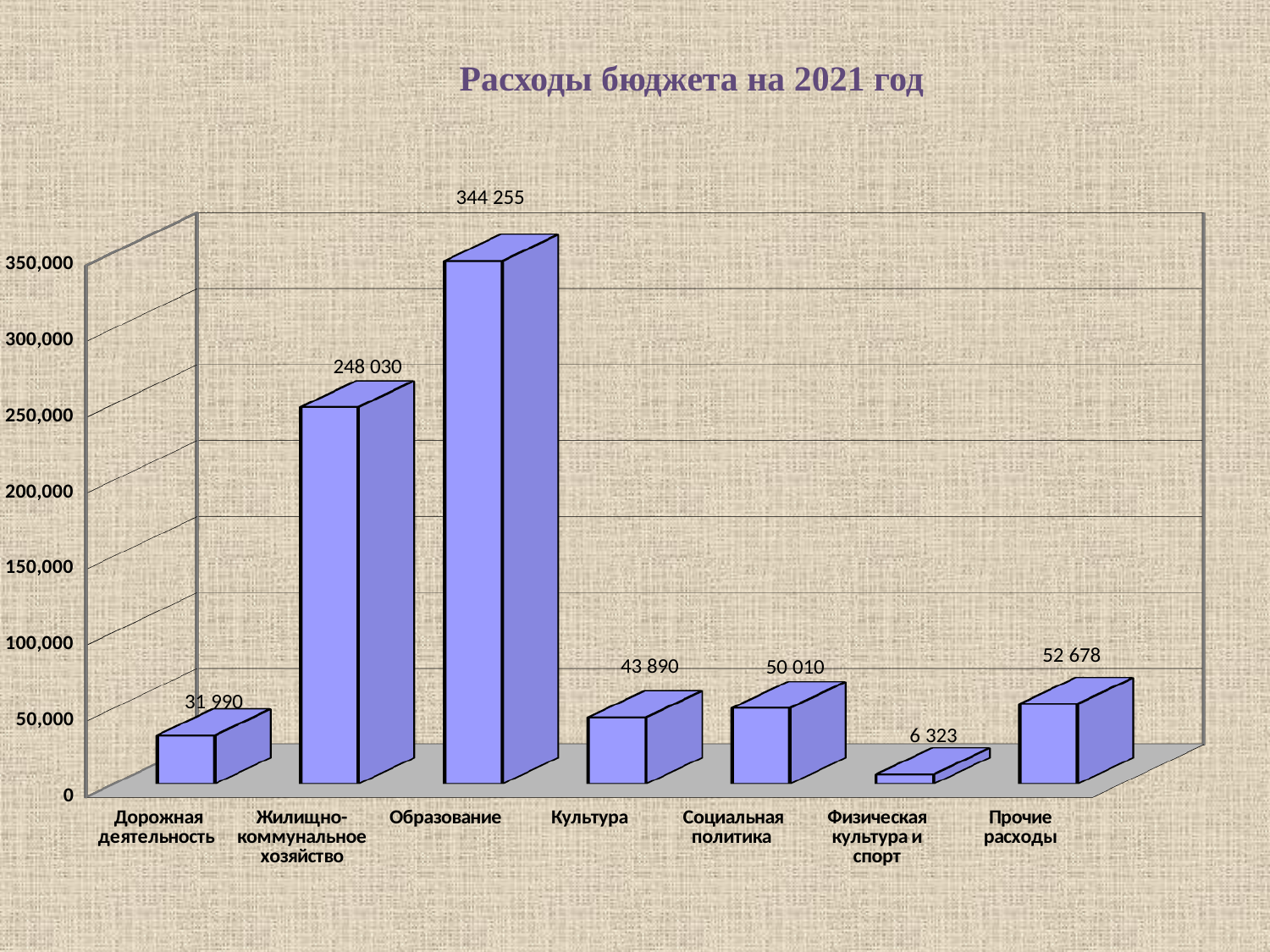
What is the value for Социальная политика? 50 010 What is the value for Жилищно-коммунальное хозяйство? 248 030 Which is larger, the value for Культура or the value for Дорожная деятельность? Культура What is the title of the chart? Расходы бюджета на 2021 год What is the difference between the values for Образование and Жилищно-коммунальное хозяйство? 96 225 What is the difference between the values for Прочие расходы and Социальная политика? 2 668 Which category has the highest value? Образование What is the value for Образование? 344 255 How many categories are shown on the chart? 7 What is the value for Физическая культура и спорт? 6 323 Which category has the lowest value? Физическая культура и спорт Is the value for Жилищно-коммунальное хозяйство greater or less than 200,000? greater